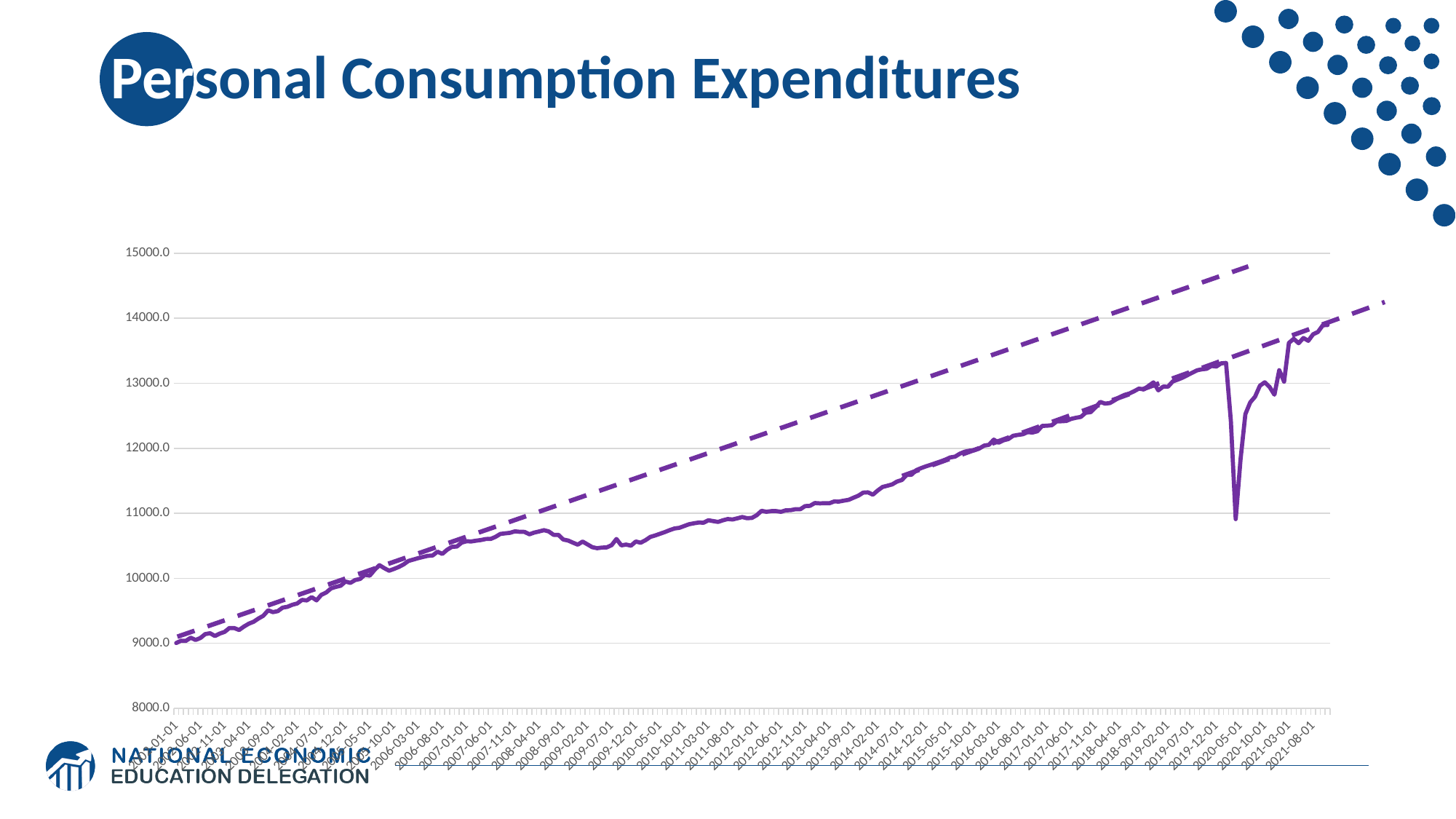
Which is higher on the solid line: the value at 2021-08-01 or the value at 2002-01-01? 2021-08-01 Is the value of the solid line at 2021-08-01 greater or less than 13000? greater Is the value of the solid line at 2002-01-01 greater or less than 10000? less Does the solid line generally rise or fall from 2002-01-01 to 2021-08-01? rise How many lines are plotted on the chart, counting both solid and dashed lines? 3 What kind of chart is shown on the slide? line chart Which is higher on the solid line: the value at 2019-12-01 or the value at 2020-05-01? 2019-12-01 Is the value of the solid line at 2015-10-01 greater or less than 11000? greater What is the title of the chart? Personal Consumption Expenditures What is the highest value labelled on the vertical axis? 15000.0